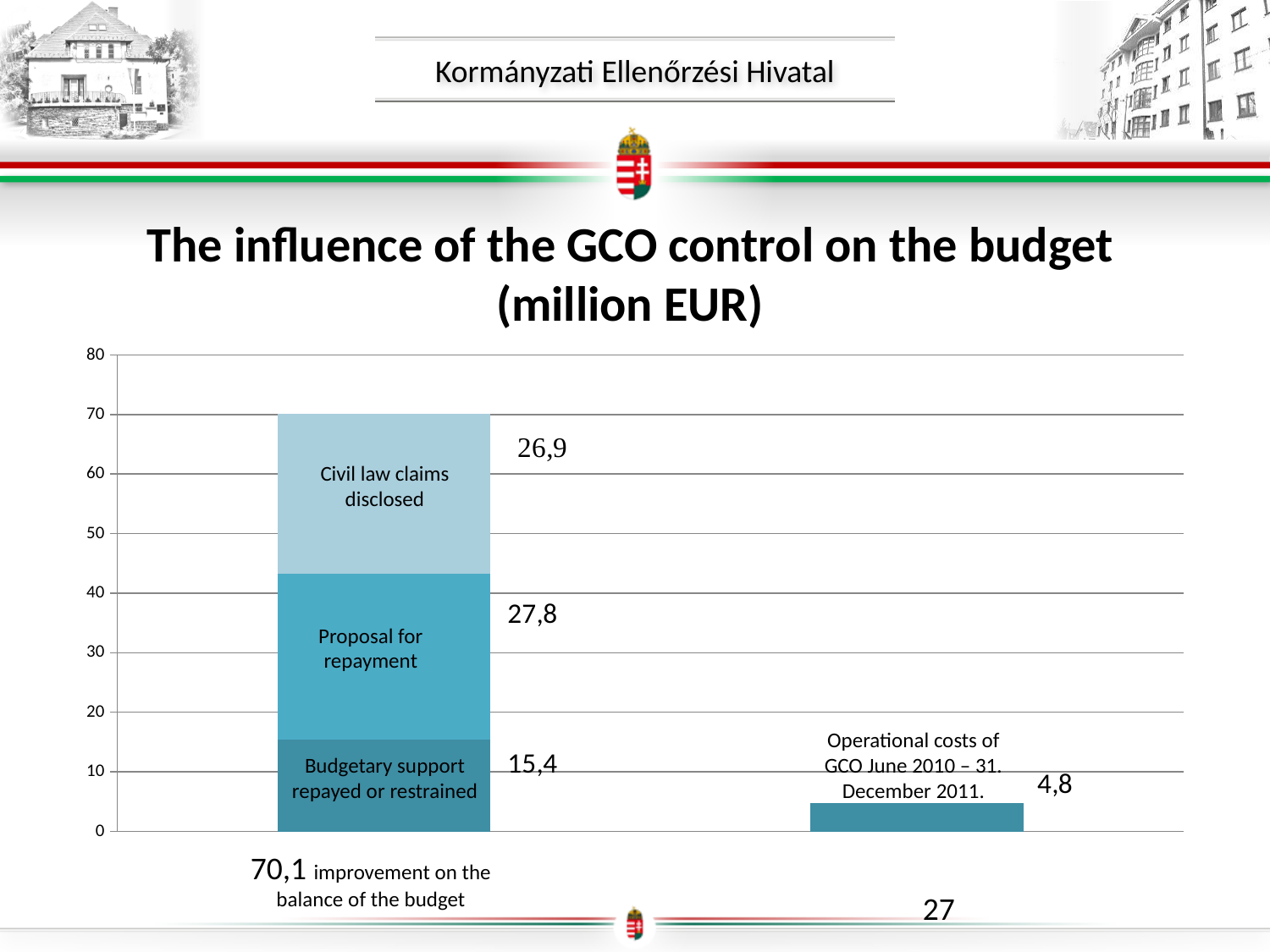
Which is larger, 'Budgetary support repayed or restrained' or 'Operational costs of GCO June 2010 – 31. December 2011.'? Budgetary support repayed or restrained What kind of chart is shown on the slide? Stacked bar chart What is the total of the stacked bar showing the improvement on the balance of the budget? 70,1 What is the difference between 'Proposal for repayment' and 'Budgetary support repayed or restrained'? 12,4 What is the title of the chart? The influence of the GCO control on the budget (million EUR) What is the value for 'Proposal for repayment'? 27,8 What is the value for 'Operational costs of GCO June 2010 – 31. December 2011.'? 4,8 Which segment of the stacked bar has the largest value? Proposal for repayment What is the value for 'Budgetary support repayed or restrained'? 15,4 What is the value for 'Civil law claims disclosed'? 26,9 Which segment of the stacked bar has the smallest value? Budgetary support repayed or restrained Is the total of the stacked bar greater or less than 60? greater